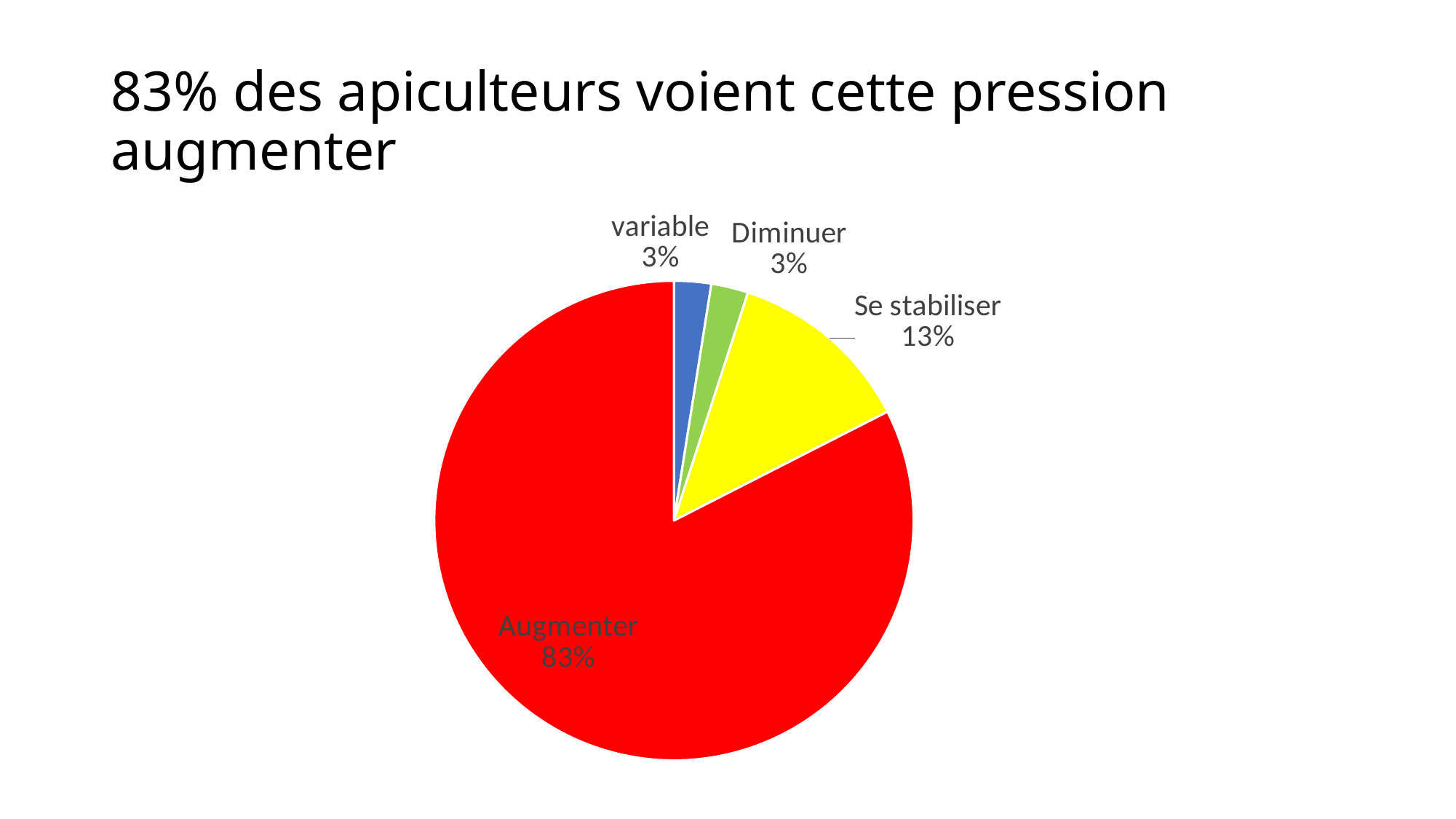
What share of the pie does the Diminuer slice represent? 3% What share of the pie does the Se stabiliser slice represent? 13% What colour is the Augmenter slice? red Which category has the largest slice of the pie? Augmenter What kind of chart is shown on the slide? pie chart What is the difference in percentage points between the Augmenter slice and the Se stabiliser slice? 70 What is the difference in percentage points between the Se stabiliser slice and the variable slice? 10 What share of the pie does the variable slice represent? 3% How many slices does the pie chart have? 4 Which slice is larger, Se stabiliser or Diminuer? Se stabiliser What colour is the Se stabiliser slice? yellow